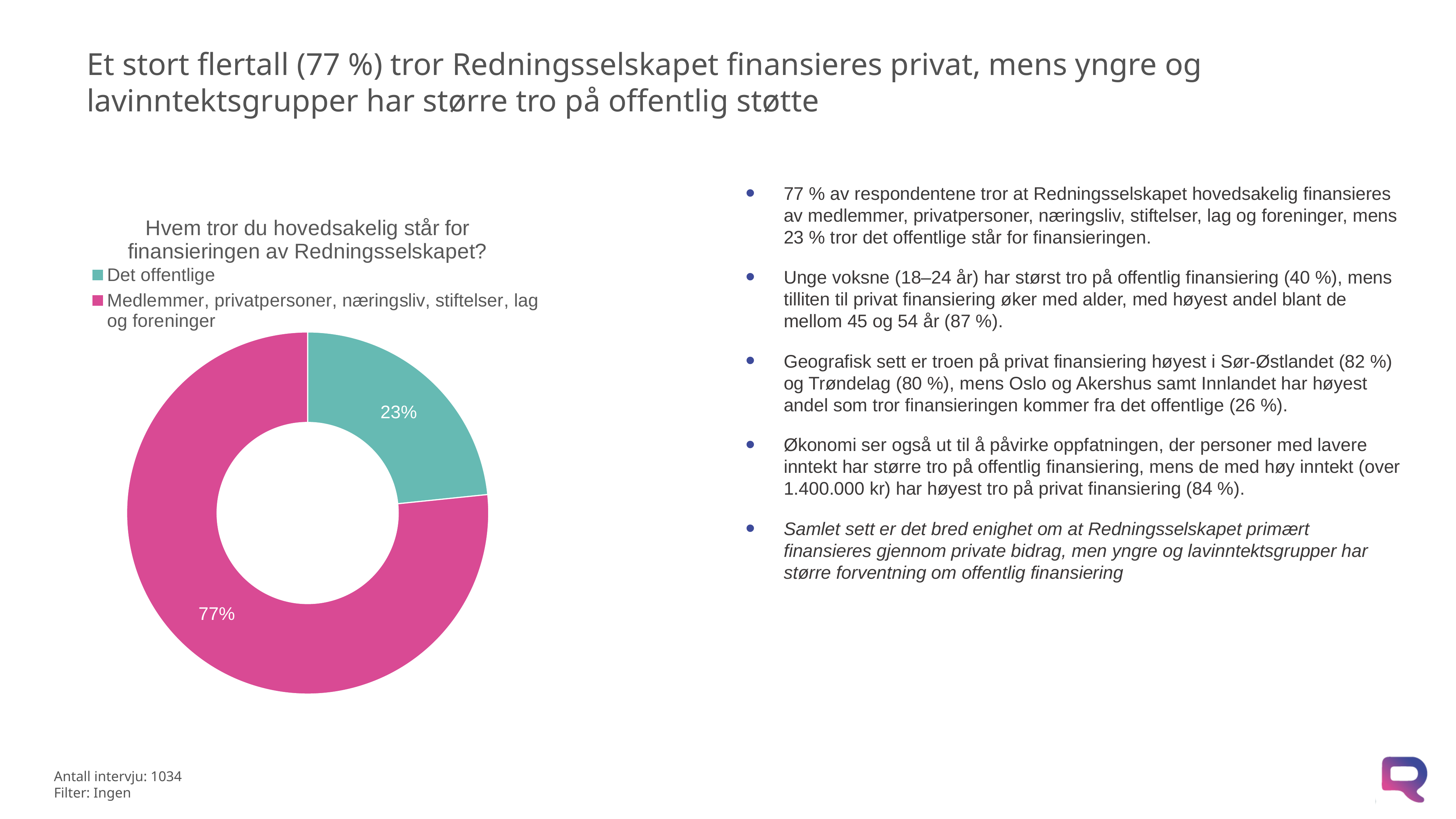
What kind of chart is shown on the slide? Pie chart (doughnut) How many categories does the pie chart show? 2 Which category has the largest share of the pie? Medlemmer, privatpersoner, næringsliv, stiftelser, lag og foreninger What share of respondents answered "Medlemmer, privatpersoner, næringsliv, stiftelser, lag og foreninger"? 77% What share of respondents answered "Det offentlige"? 23% What is the title of the chart? Hvem tror du hovedsakelig står for finansieringen av Redningsselskapet? Which category has the smallest share of the pie? Det offentlige How many entries does the legend list? 2 What colour is the slice for "Det offentlige"? Teal (green) Which is larger: the share for "Det offentlige" or the share for "Medlemmer, privatpersoner, næringsliv, stiftelser, lag og foreninger"? Medlemmer, privatpersoner, næringsliv, stiftelser, lag og foreninger What is the difference in percentage points between the two slices? 54 percentage points What is the total of the two slices shown in the chart? 100%